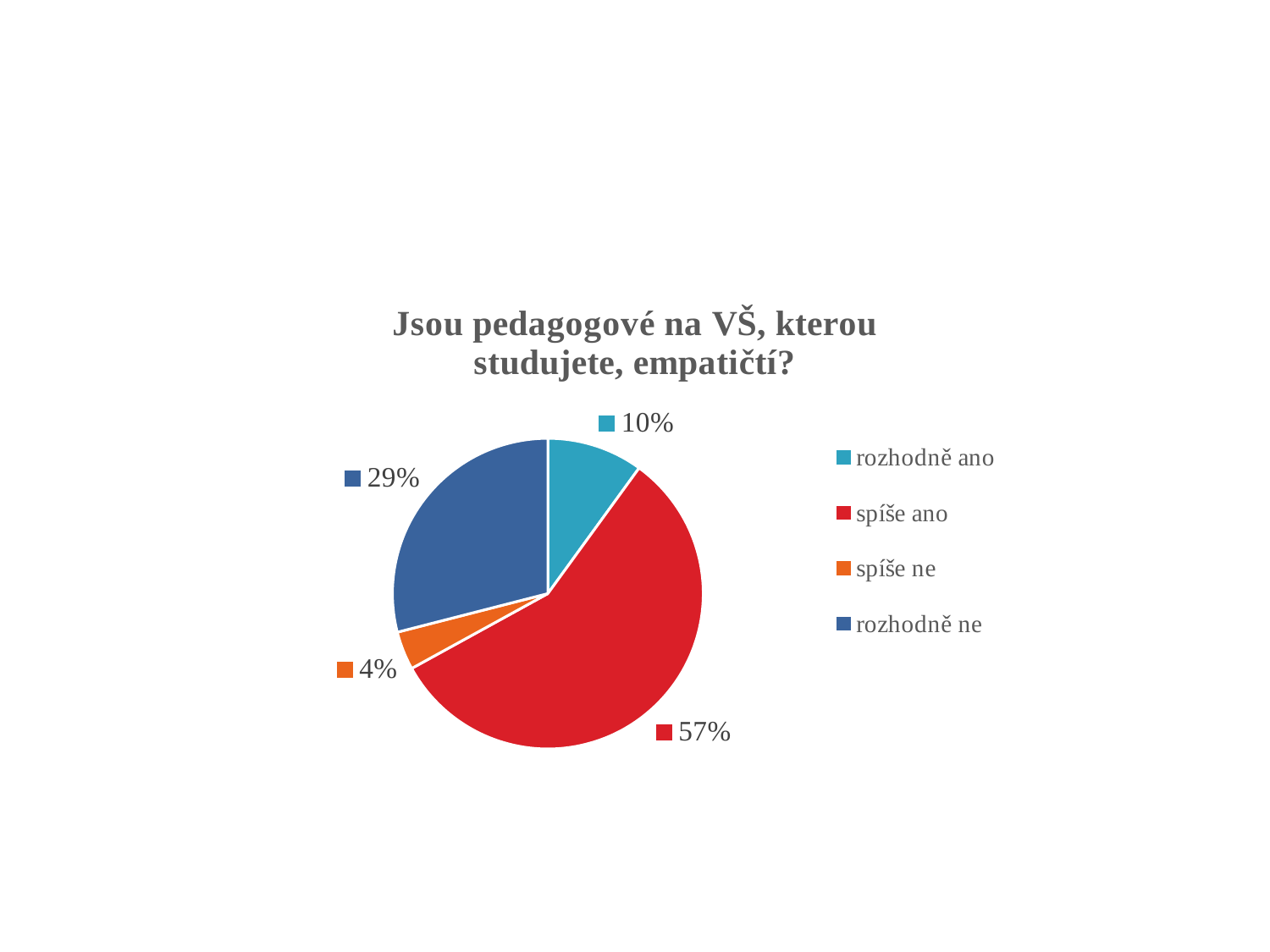
What percentage of the pie is 'rozhodně ne'? 29% What percentage of the pie is 'rozhodně ano'? 10% What kind of chart is shown on the slide? pie chart What percentage of the pie is 'spíše ne'? 4% Which is larger, the share for 'rozhodně ano' or the share for 'rozhodně ne'? rozhodně ne What is the title of the chart? Jsou pedagogové na VŠ, kterou studujete, empatičtí? How many categories does the pie chart have? 4 Which category has the largest share of the pie? spíše ano What colour is the slice for 'spíše ne'? orange Which category has the smallest share of the pie? spíše ne What is the difference in percentage points between 'spíše ano' and 'rozhodně ne'? 28 What percentage of the pie is 'spíše ano'? 57%